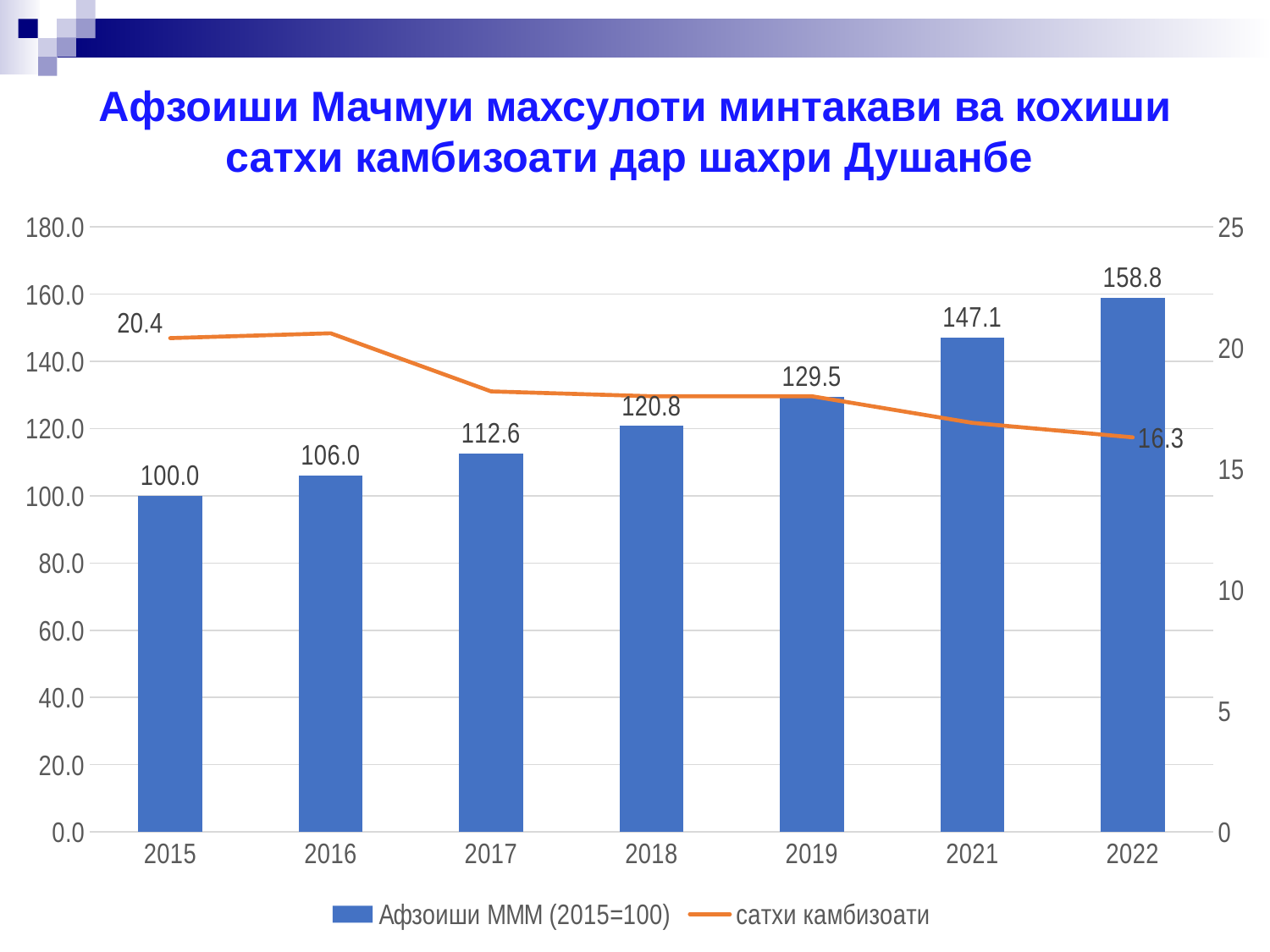
How many series does the legend list? 2 Do the Афзоиши ММM (2015=100) bars rise or fall from 2015 to 2022? rise What is the value of сатхи камбизоати for 2015? 20.4 What is the value of Афзоиши ММM (2015=100) for 2018? 120.8 What is the difference between the Афзоиши ММM (2015=100) values for 2022 and 2021? 11.7 Is the value of сатхи камбизоати for 2018 greater or less than 20? less Which year has the highest value of Афзоиши ММM (2015=100)? 2022 What is the value of сатхи камбизоати for 2022? 16.3 What is the value of Афзоиши ММM (2015=100) for 2021? 147.1 Which is larger, the Афзоиши ММM (2015=100) value for 2017 or for 2019? 2019 How many years are shown on the x axis? 7 Which year has the lowest value of Афзоиши ММM (2015=100)? 2015